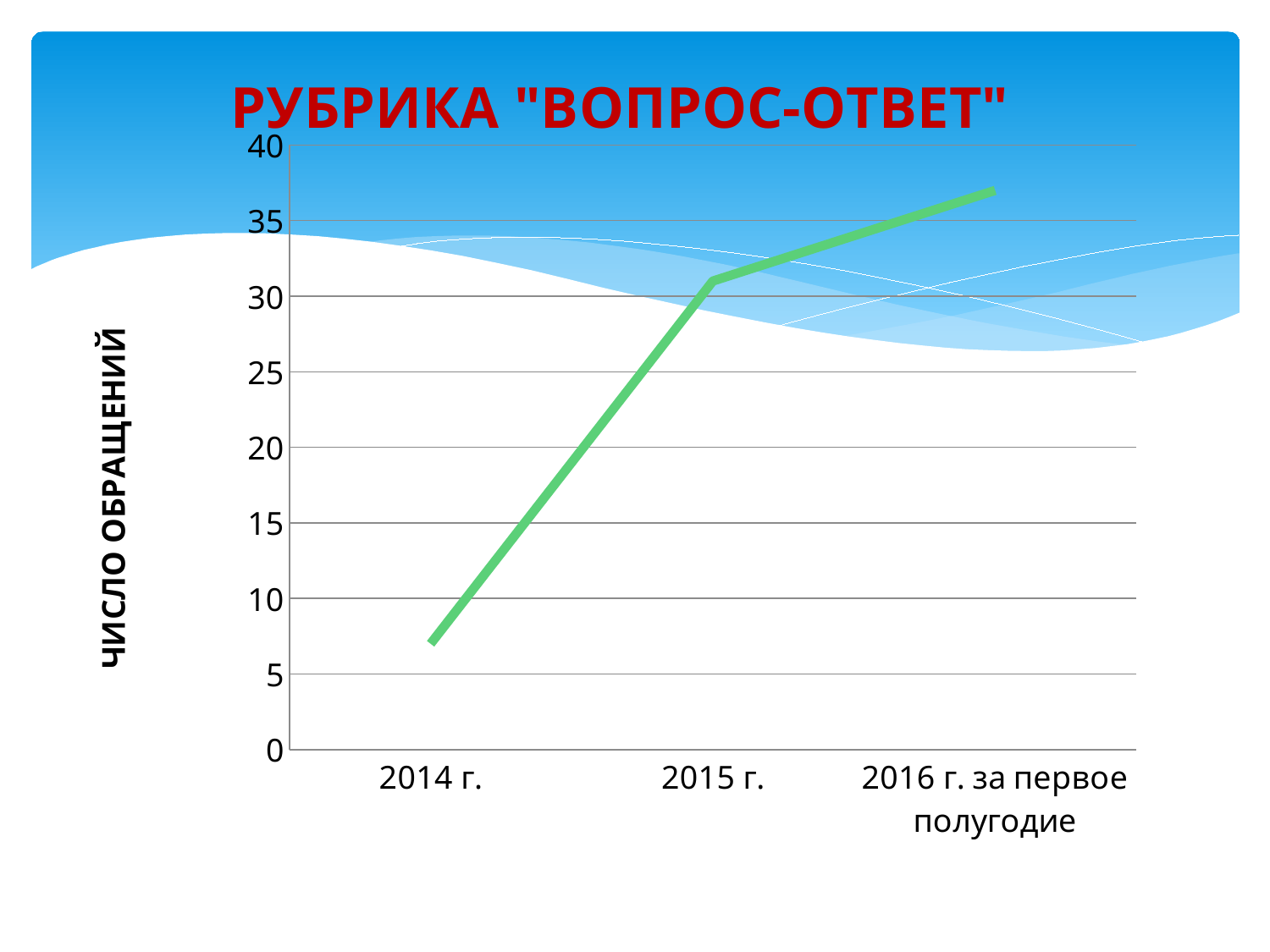
Which category has the highest value? 2016 г. за первое полугодие Is the value for 2015 г. greater or less than 25? greater Which is larger, the value for 2014 г. or the value for 2015 г.? 2015 г. How many data points are plotted on the chart? 3 Is the value for 2014 г. greater or less than 10? less Do the values rise or fall from 2014 г. to 2016 г. за первое полугодие? rise What kind of chart is shown on the slide? line chart Which category has the lowest value? 2014 г. What is the label on the vertical axis? ЧИСЛО ОБРАЩЕНИЙ What is the title of the chart? РУБРИКА "ВОПРОС-ОТВЕТ" Is the value for 2016 г. за первое полугодие greater or less than 35? greater